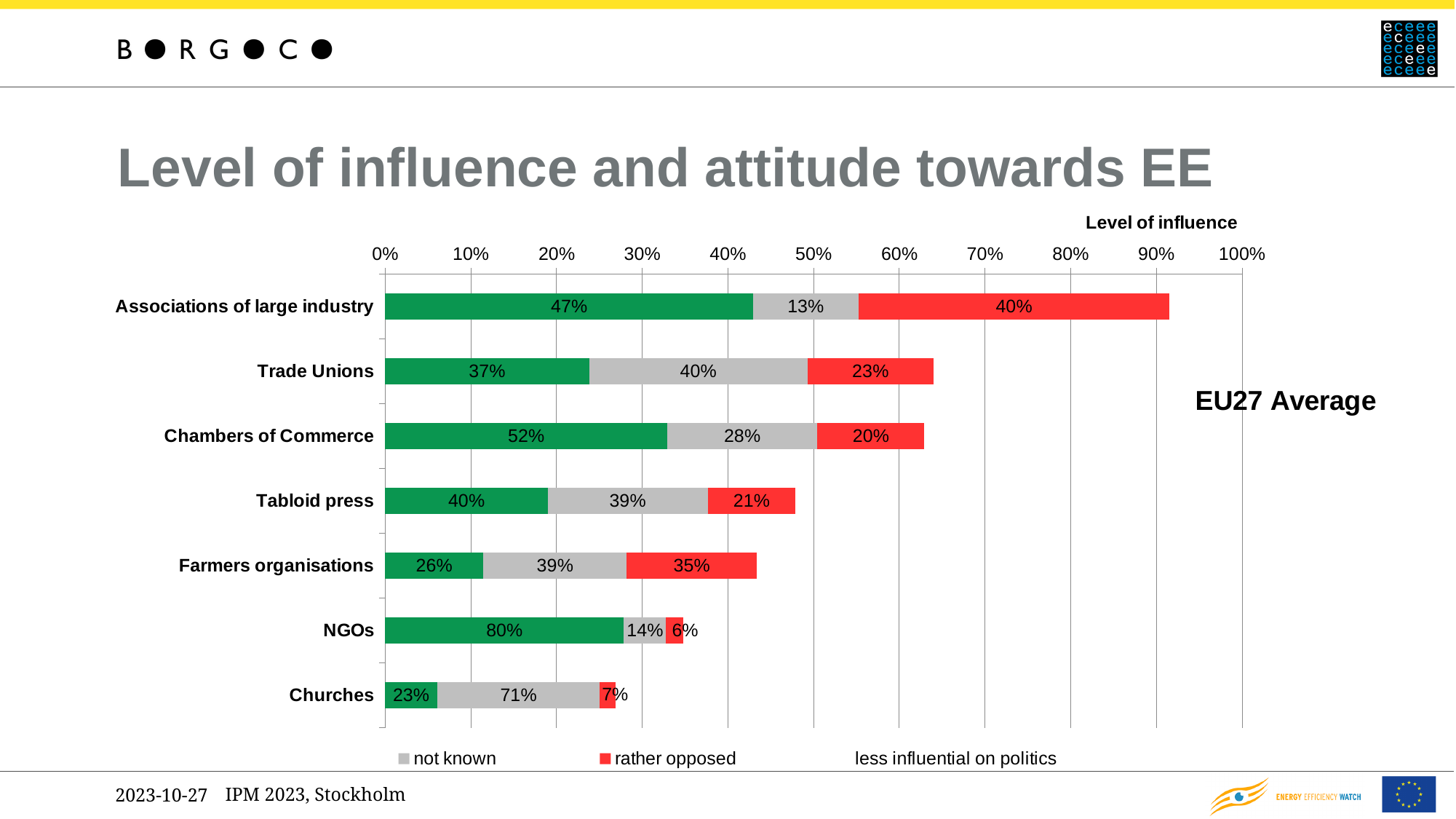
What is the 'rather opposed' percentage label for Farmers organisations? 35% What is the green segment percentage label for NGOs? 80% Which category has the longest bar (highest level of influence)? Associations of large industry What is the 'not known' (grey) percentage label for Churches? 71% Which category has the highest 'not known' percentage label? Churches Is the total bar length for Churches greater or less than 30%? less What kind of chart is shown on the slide? stacked bar chart What is the difference between the green segment labels for NGOs (80%) and Churches (23%)? 57 percentage points How many organisation categories are listed on the vertical axis of the chart? 7 Which is larger: the 'rather opposed' label for Farmers organisations or for Tabloid press? Farmers organisations What is the 'rather opposed' (red) percentage label for Associations of large industry? 40% Which category has the shortest bar (lowest level of influence)? Churches